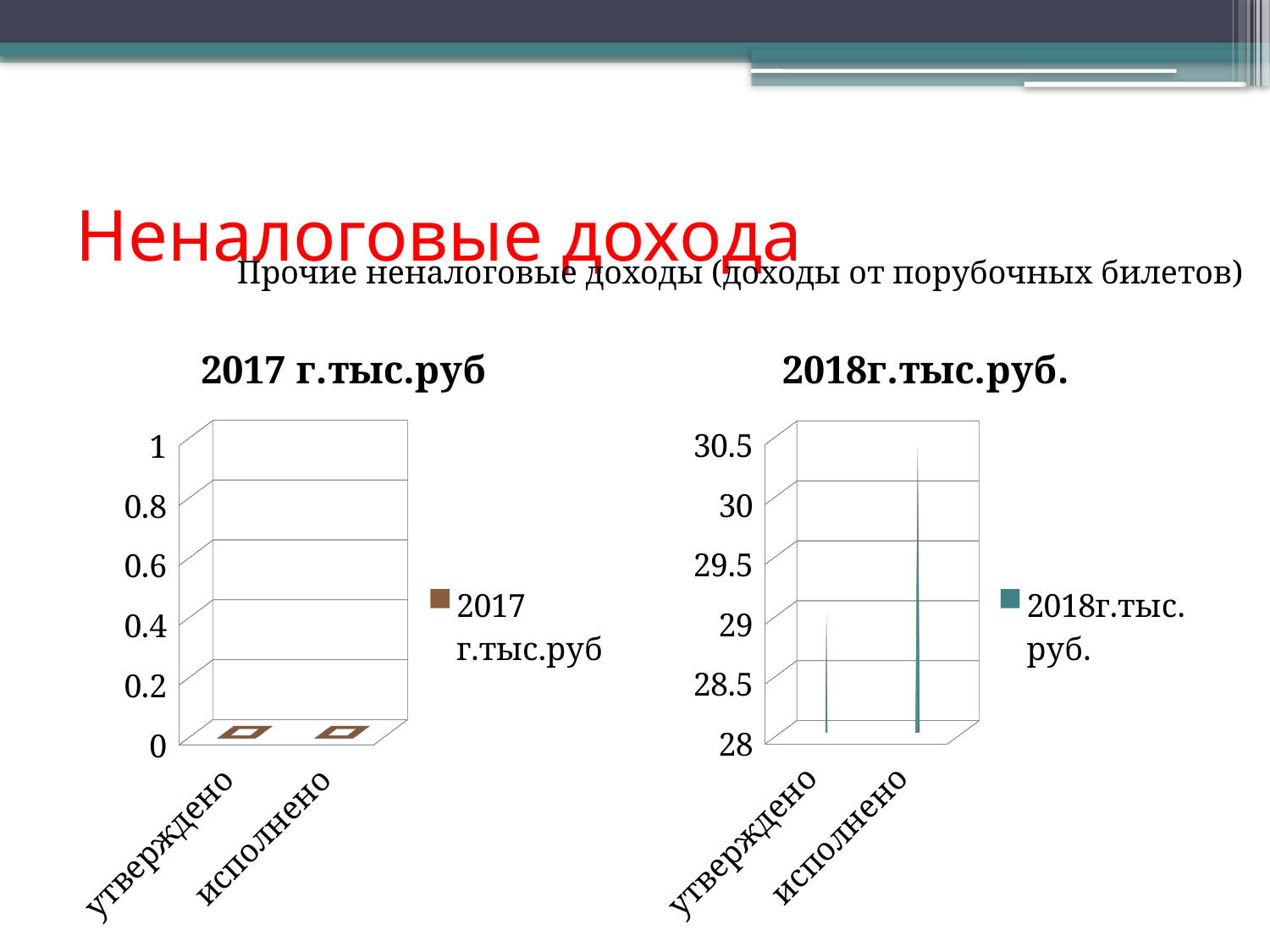
In the chart titled "2017 г.тыс.руб", is the value for исполнено greater or less than 0.2? less In the chart titled "2018г.тыс.руб.", is the value for исполнено greater or less than 30? greater In the chart titled "2018г.тыс.руб.", which category has the highest value? исполнено In the chart titled "2018г.тыс.руб.", which category has the lowest value? утверждено What kind of chart is the chart titled "2017 г.тыс.руб"? bar chart How many categories are shown on the x axis of the chart titled "2018г.тыс.руб."? 2 What is the legend entry of the chart on the right of the slide? 2018г.тыс.руб. In the chart titled "2018г.тыс.руб.", is the value for утверждено greater or less than 29.5? less In the chart titled "2018г.тыс.руб.", which is larger: утверждено or исполнено? исполнено How many series does the legend of the chart titled "2017 г.тыс.руб" list? 1 What kind of chart is the chart titled "2018г.тыс.руб."? bar chart In the chart titled "2018г.тыс.руб.", do the values rise or fall from утверждено to исполнено? rise